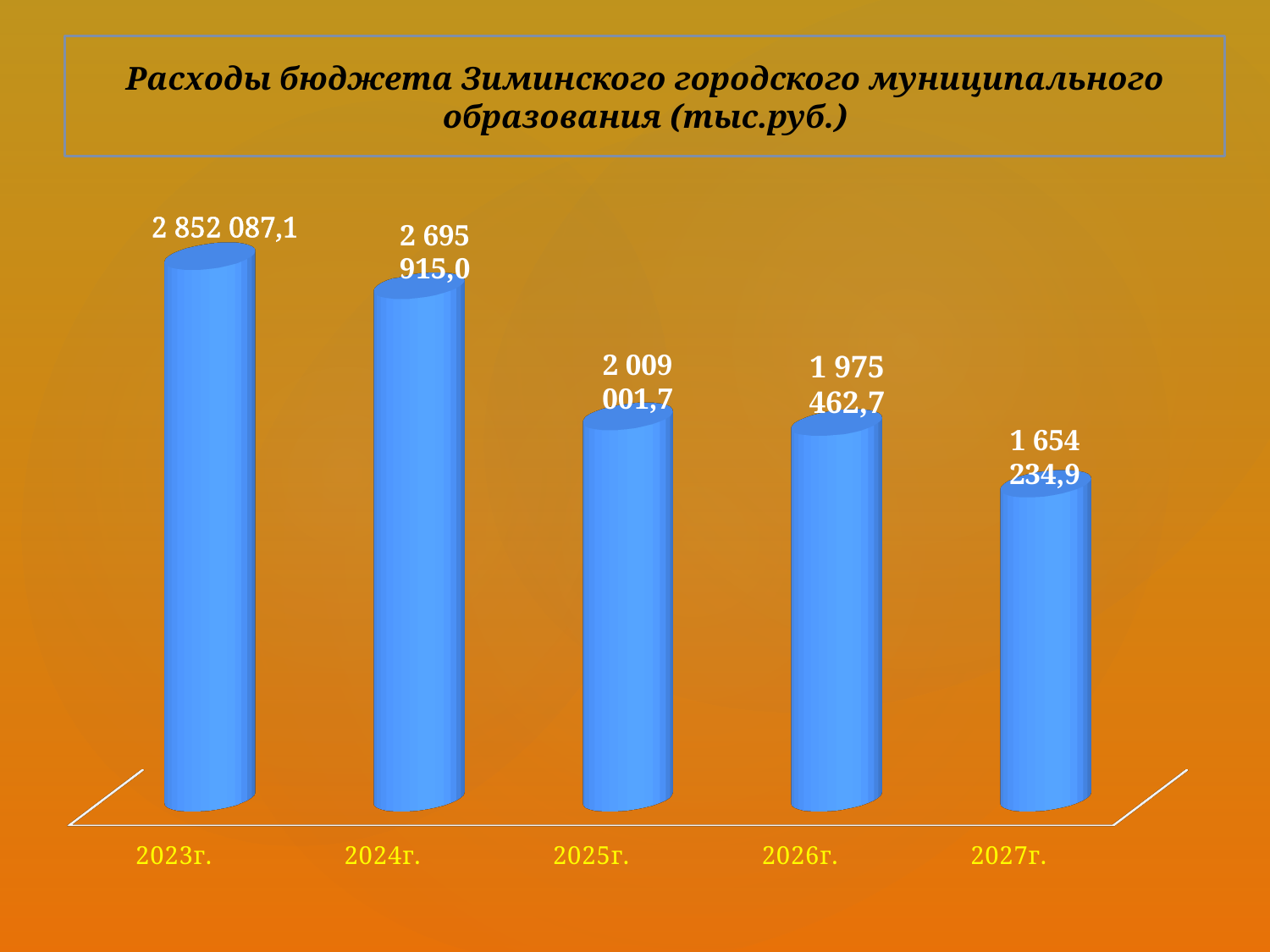
How many years are shown on the chart? 5 Which year has the highest expenditure value? 2023г. Which year has the lowest expenditure value? 2027г. What is the value shown for 2025г.? 2 009 001,7 What is the value shown for 2026г.? 1 975 462,7 Do the values rise or fall from 2023г. to 2027г.? Fall What is the value shown for 2027г.? 1 654 234,9 What is the budget expenditure value shown for 2023г.? 2 852 087,1 What is the difference between the values for 2023г. and 2024г.? 156 172,1 What kind of chart is shown on the slide? Bar chart Which is larger, the value for 2024г. or the value for 2025г.? 2024г. What is the difference between the values for 2026г. and 2027г.? 321 227,8